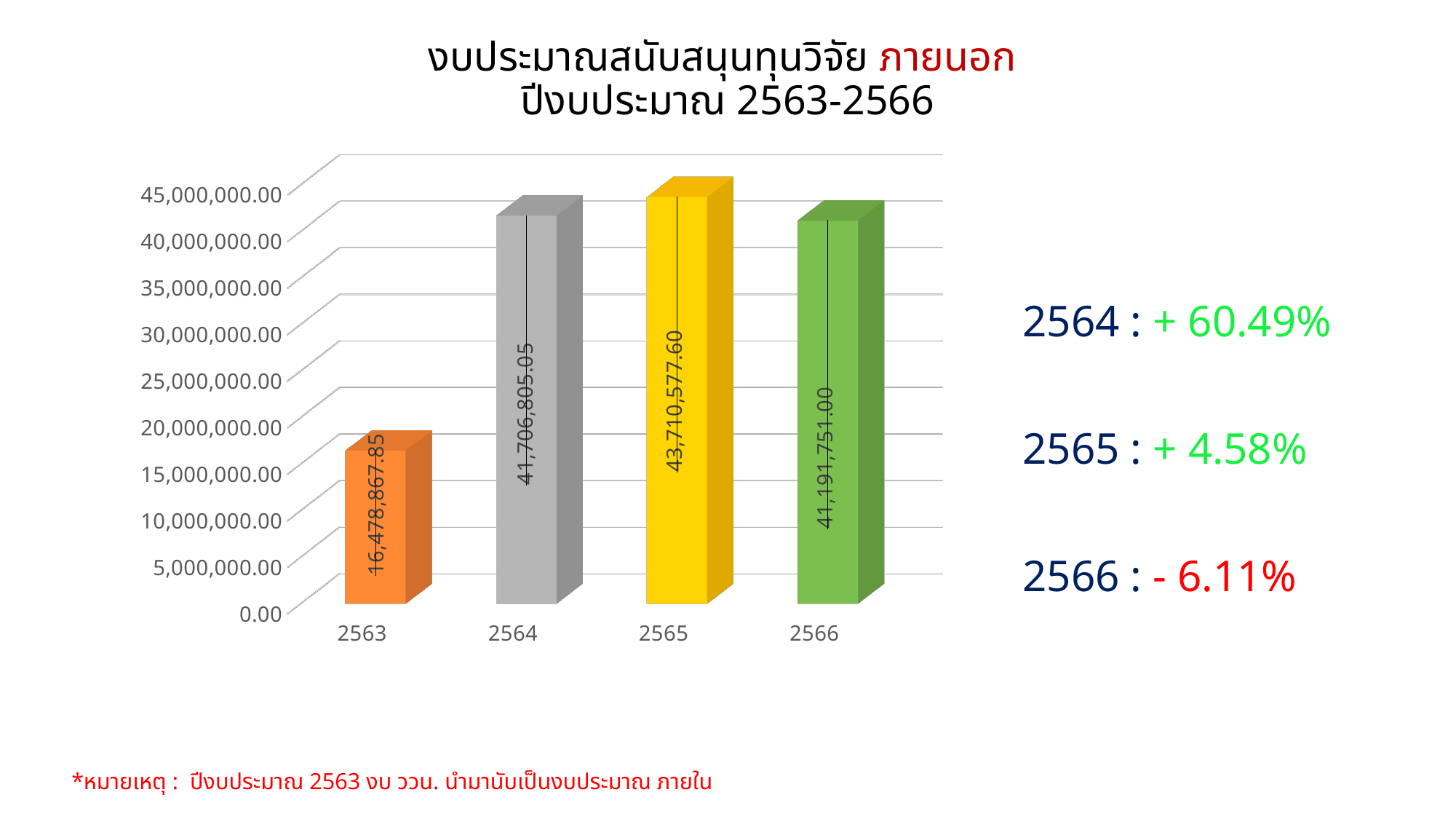
Which year has the lowest value? 2563 What percentage change is shown next to the chart for 2564? + 60.49% What is the difference between the values for 2565 and 2564? 2,003,772.55 What is the difference between the values for 2564 and 2563? 25,227,937.20 What is the value for 2563? 16,478,867.85 Which is larger, the value for 2565 or the value for 2566? 2565 Which year has the highest value? 2565 Is the value for 2563 greater or less than 20,000,000.00? less What is the value for 2565? 43,710,577.60 What kind of chart is shown on the slide? bar chart How many years are shown on the x axis? 4 What is the value for 2566? 41,191,751.00